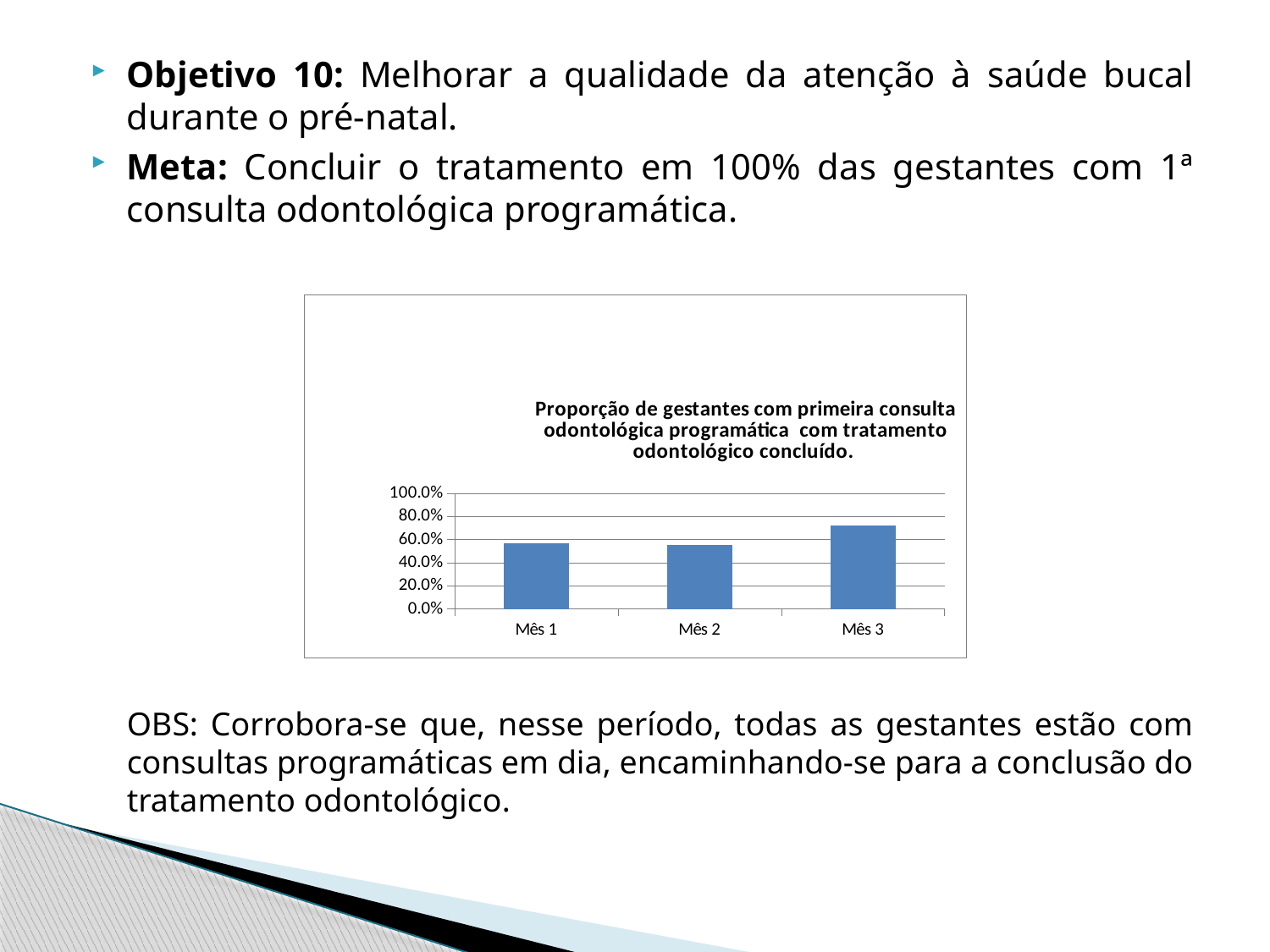
What is the highest value shown on the chart's vertical axis? 100.0% What is the title of the chart? Proporção de gestantes com primeira consulta odontológica programática com tratamento odontológico concluído. Is the value for Mês 1 greater or less than 40.0%? greater What kind of chart is shown on the slide? Bar chart Is the value for Mês 3 greater or less than 60.0%? greater Which month has the highest value on the chart? Mês 3 Is the value for Mês 2 greater or less than 60.0%? less Which is larger, the value for Mês 3 or the value for Mês 1? Mês 3 How many categories (months) are plotted on the chart? 3 Which is larger, the value for Mês 2 or the value for Mês 3? Mês 3